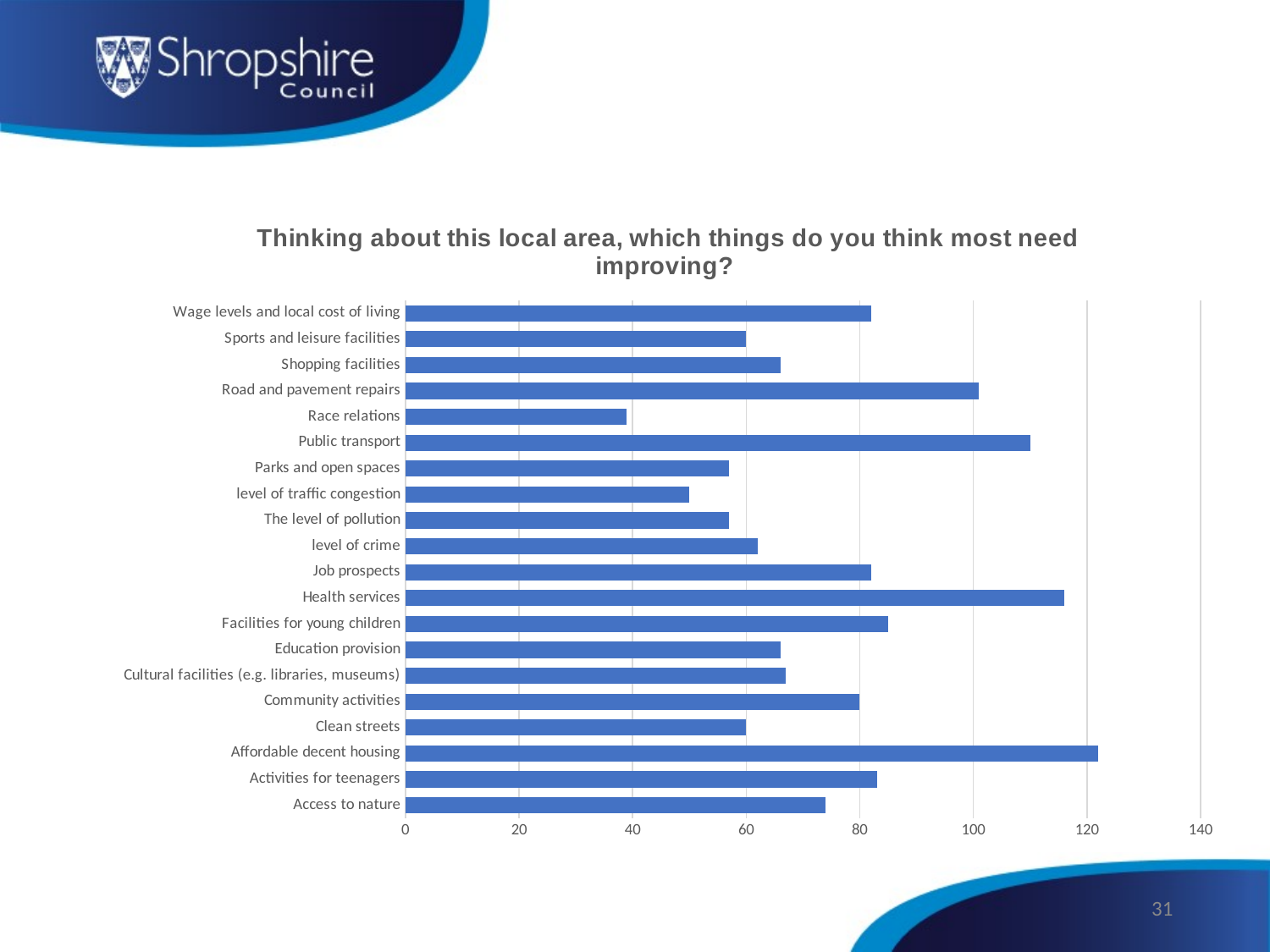
Which category has the lowest value? Race relations Is the value for Health services greater or less than 100? greater Which category has the highest value? Affordable decent housing What is the title of the chart? Thinking about this local area, which things do you think most need improving? Is the value for Public transport greater or less than 100? greater What kind of chart is shown on the slide? Bar chart Is the value for Race relations greater or less than 60? less Which has the larger value, Activities for teenagers or Access to nature? Activities for teenagers Which has the larger value, Public transport or Road and pavement repairs? Public transport How many categories are plotted in the chart? 20